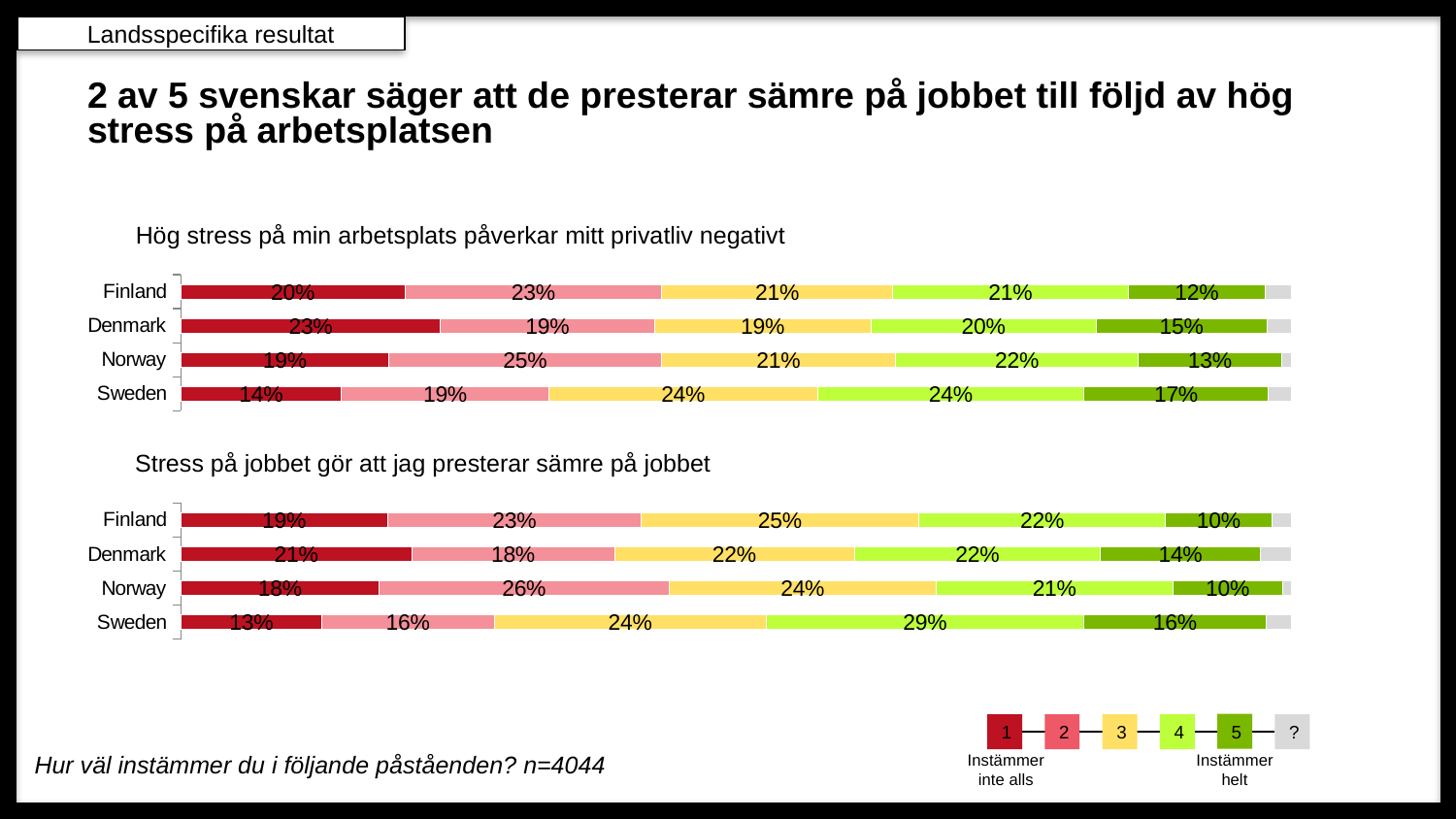
In the chart 'Stress på jobbet gör att jag presterar sämre på jobbet', what is the value of the pink (rating 2) segment for Norway? 26% In the chart 'Hög stress på min arbetsplats påverkar mitt privatliv negativt', what is the difference between the pink (rating 2) segment for Norway and for Denmark? 6% In the chart 'Hög stress på min arbetsplats påverkar mitt privatliv negativt', what is the value of the first (dark red, rating 1) segment for Denmark? 23% In the chart 'Stress på jobbet gör att jag presterar sämre på jobbet', what is the value of the light green (rating 4) segment for Sweden? 29% According to the scale at the bottom of the slide, what does rating 5 mean? Instämmer helt In the chart 'Stress på jobbet gör att jag presterar sämre på jobbet', is the yellow (rating 3) segment larger for Finland or for Denmark? Finland In the chart 'Stress på jobbet gör att jag presterar sämre på jobbet', which country has the lowest value for the dark red (rating 1) segment? Sweden How many countries are shown in the chart 'Stress på jobbet gör att jag presterar sämre på jobbet'? 4 In the chart 'Hög stress på min arbetsplats påverkar mitt privatliv negativt', which country has the highest value for the dark green (rating 5) segment? Sweden In the chart 'Hög stress på min arbetsplats påverkar mitt privatliv negativt', what is the value of the last (dark green, rating 5) segment for Sweden? 17% What type of chart is used for 'Hög stress på min arbetsplats påverkar mitt privatliv negativt'? Stacked bar chart In the chart 'Stress på jobbet gör att jag presterar sämre på jobbet', what is the combined value of the rating 4 and rating 5 segments for Sweden? 45%